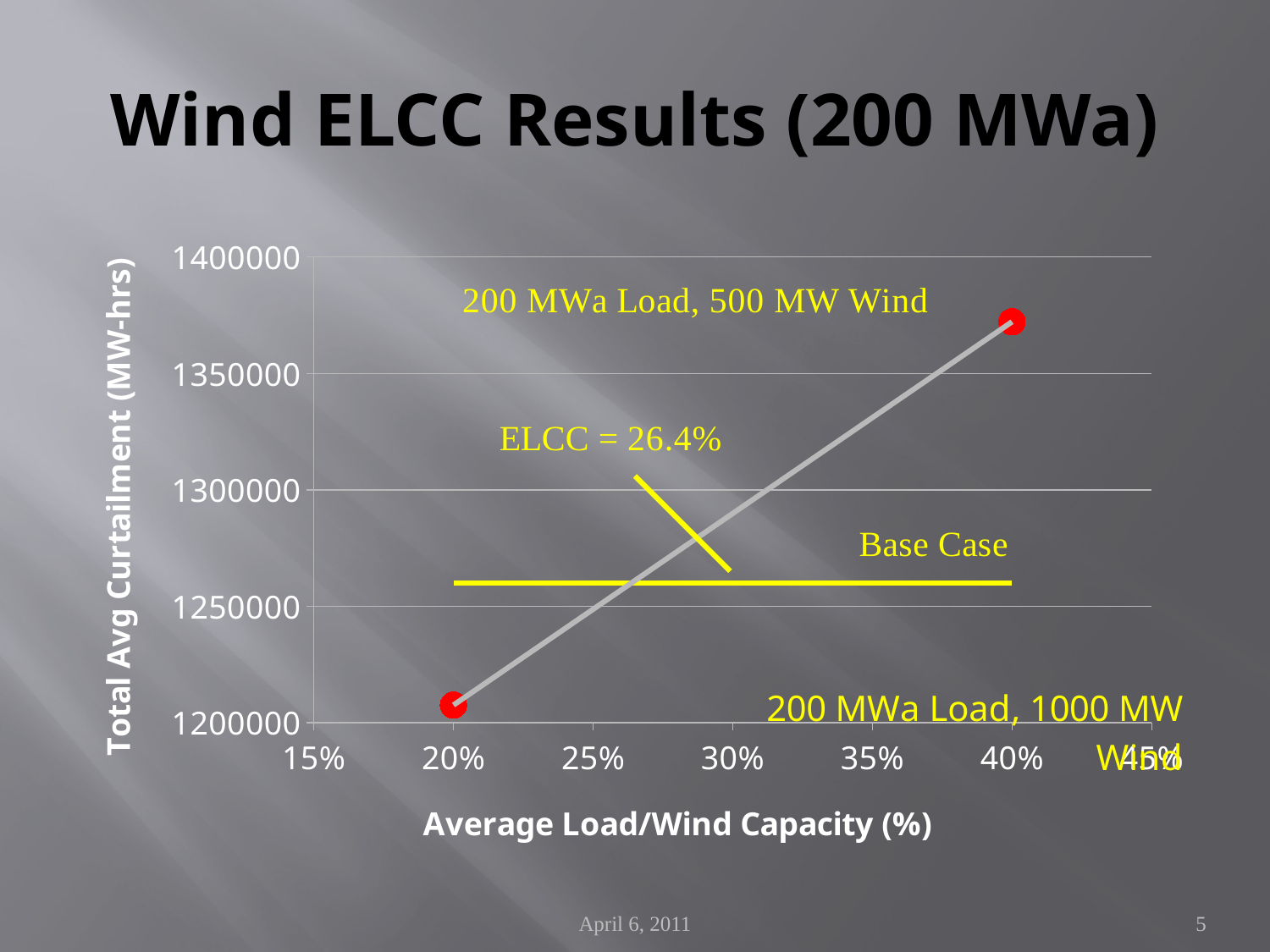
Is the Base Case line greater or less than 1300000 MW-hrs? less Is the Total Avg Curtailment value at 40% Average Load/Wind Capacity greater or less than 1350000? greater How many data points are plotted on the chart? 2 What is the label of the x axis? Average Load/Wind Capacity (%) What ELCC value is annotated on the chart? ELCC = 26.4% What is the highest value shown on the y axis? 1400000 What is the title of the chart on the slide? Wind ELCC Results (200 MWa) Which annotation labels the point at 40% Average Load/Wind Capacity? 200 MWa Load, 500 MW Wind Is the Total Avg Curtailment value at 20% Average Load/Wind Capacity greater or less than 1250000? less At which Average Load/Wind Capacity value is the Total Avg Curtailment lowest? 20% Does the plotted line rise or fall as the x axis increases from 20% to 40%? rise Which plotted point has the higher Total Avg Curtailment, the one at 20% or the one at 40%? 40%